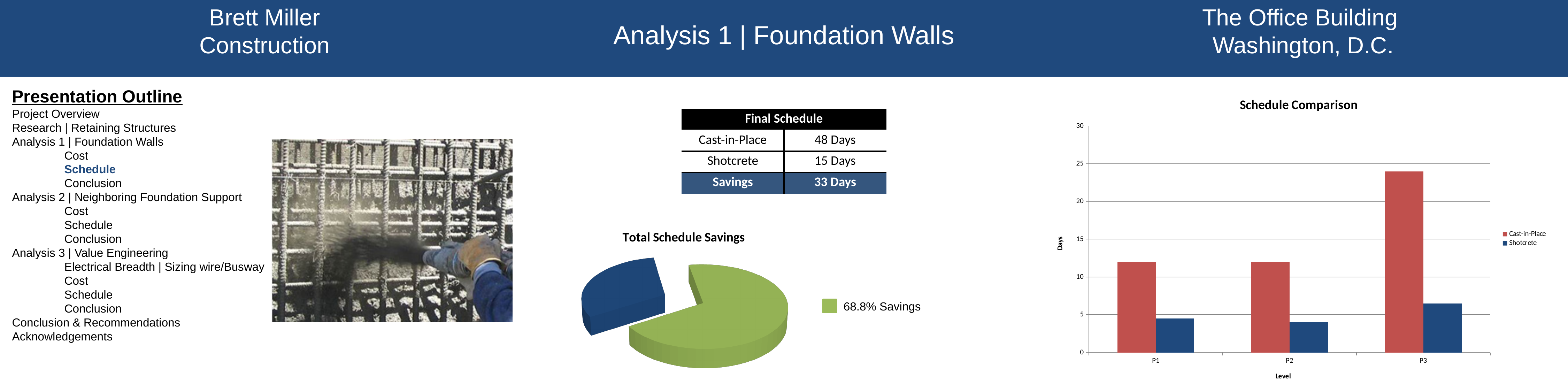
In the Total Schedule Savings pie chart, what share does the green slice represent according to the legend? 68.8% Savings In the Schedule Comparison chart, at P3, which is larger: Cast-in-Place or Shotcrete? Cast-in-Place In the Schedule Comparison chart, is the Shotcrete value for P1 greater or less than 10? less In the Schedule Comparison chart, how many levels are shown on the x axis? 3 In the Schedule Comparison chart, is the Cast-in-Place value for P3 greater or less than 20? greater In the Schedule Comparison chart, which level has the highest Cast-in-Place value? P3 What kind of chart is the Schedule Comparison chart? bar chart In the Schedule Comparison chart, which level has the highest Shotcrete value? P3 In the Schedule Comparison chart, what is the title of the vertical axis? Days In the Schedule Comparison chart, is the Cast-in-Place value for P1 greater or less than 10? greater In the Schedule Comparison chart, how many series does the legend list? 2 What kind of chart is the Total Schedule Savings chart? pie chart